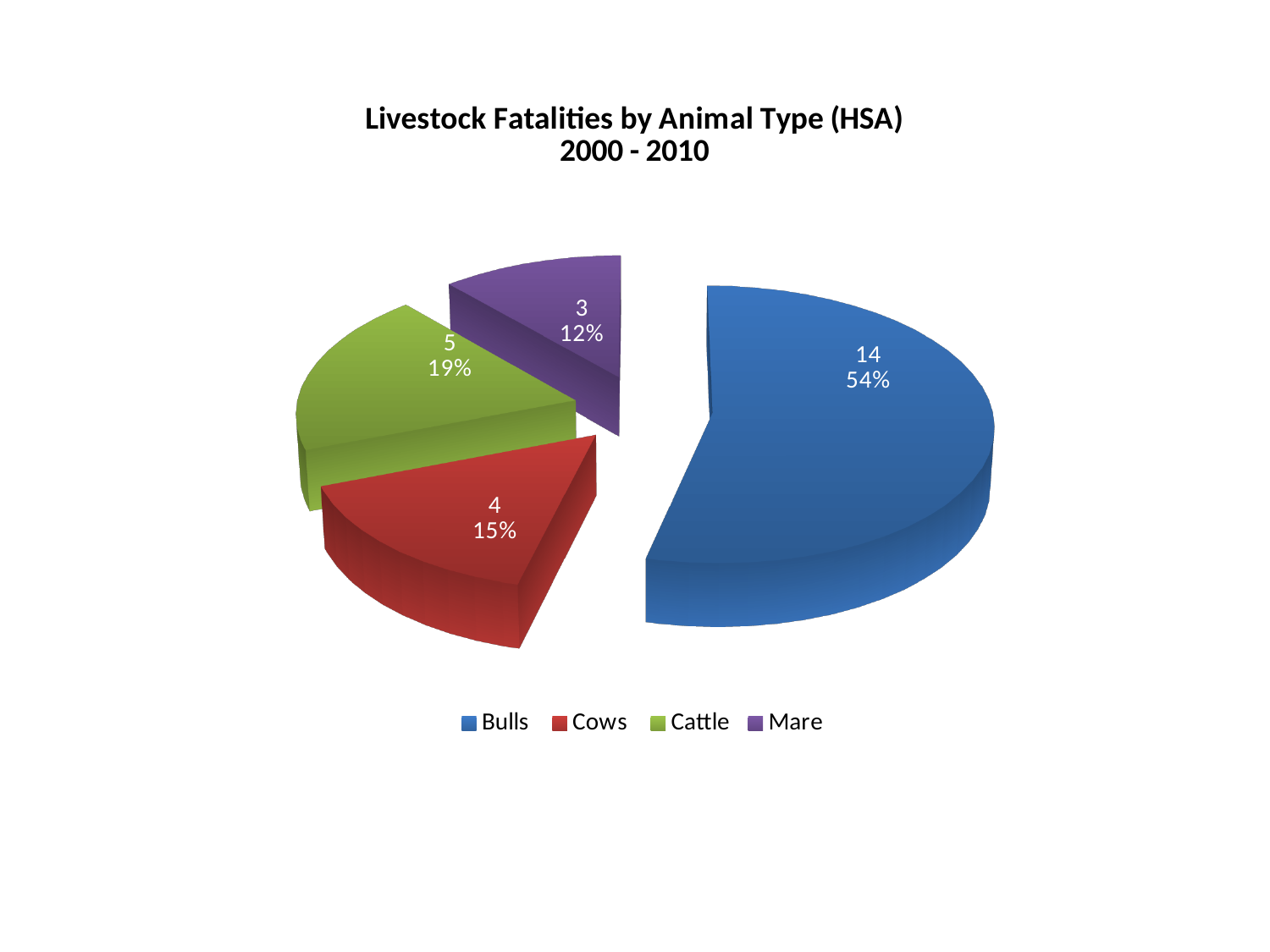
What is the difference between the number of fatalities for Bulls and for Cattle? 9 How many fatalities are attributed to Bulls? 14 Which animal type accounts for the fewest fatalities? Mare How many fatalities are attributed to Mare? 3 Which animal type accounts for the most fatalities? Bulls How many fatalities are attributed to Cattle? 5 How many fatalities are attributed to Cows? 4 What share of the pie does the Bulls slice represent? 54% How many animal types are shown in the pie chart? 4 What share of the pie does the Cattle slice represent? 19% Which has more fatalities, Cows or Cattle? Cattle What type of chart is shown on the slide? pie chart